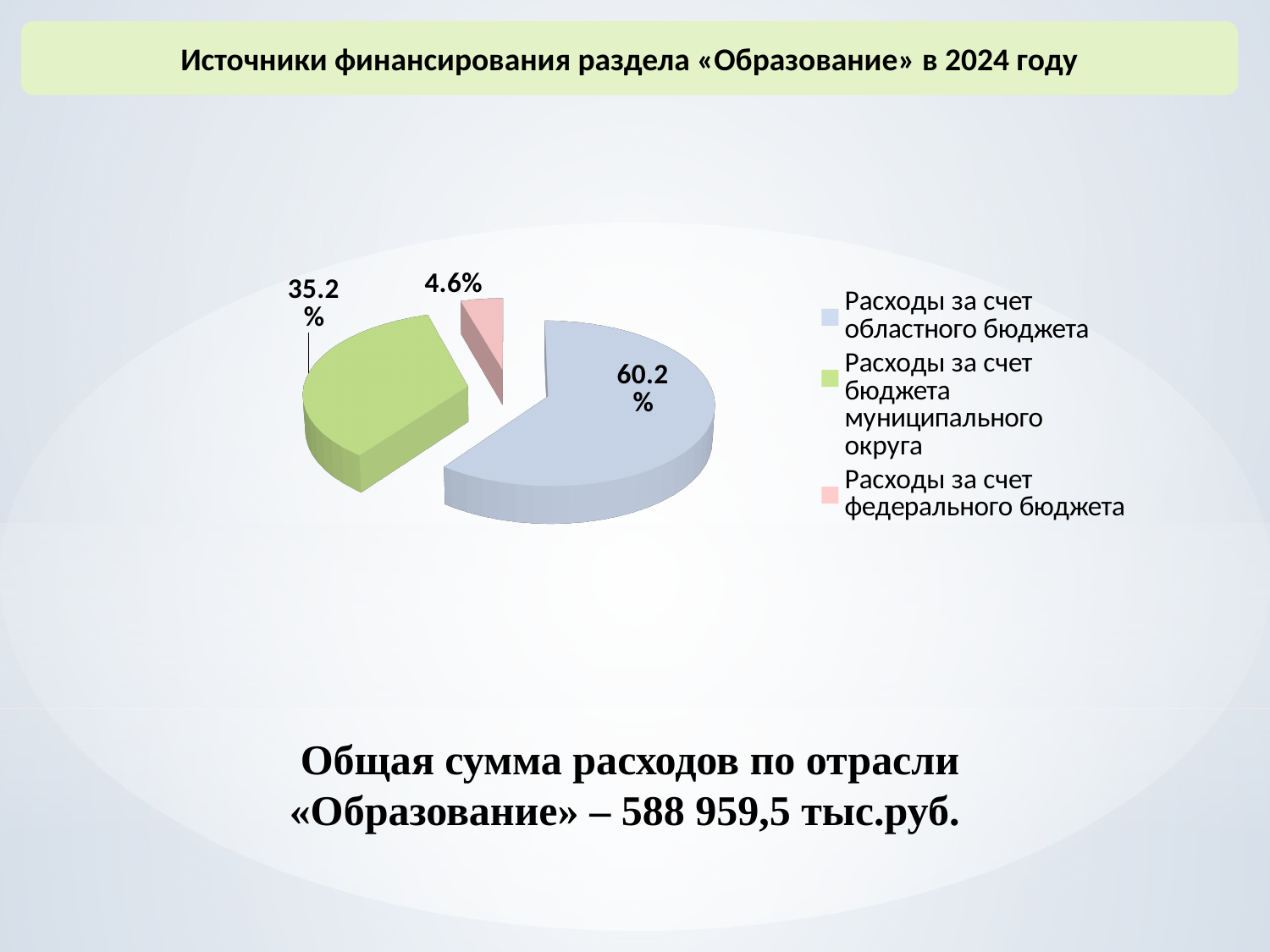
Which is larger: the share for the бюджет муниципального округа or the share for the федеральный бюджет? Расходы за счет бюджета муниципального округа How many slices does the pie chart have? 3 What share of the pie is for «Расходы за счет областного бюджета»? 60.2% Which funding source has the largest share of the pie? Расходы за счет областного бюджета How many entries does the legend list? 3 What colour is the slice for «Расходы за счет бюджета муниципального округа»? Green What is the title of the slide above the chart? Источники финансирования раздела «Образование» в 2024 году What kind of chart is shown on the slide? Pie chart What is the difference in percentage points between the share for the областной бюджет and the share for the бюджет муниципального округа? 25 percentage points What share of the pie is for «Расходы за счет федерального бюджета»? 4.6% What share of the pie is for «Расходы за счет бюджета муниципального округа»? 35.2% Which funding source has the smallest share of the pie? Расходы за счет федерального бюджета